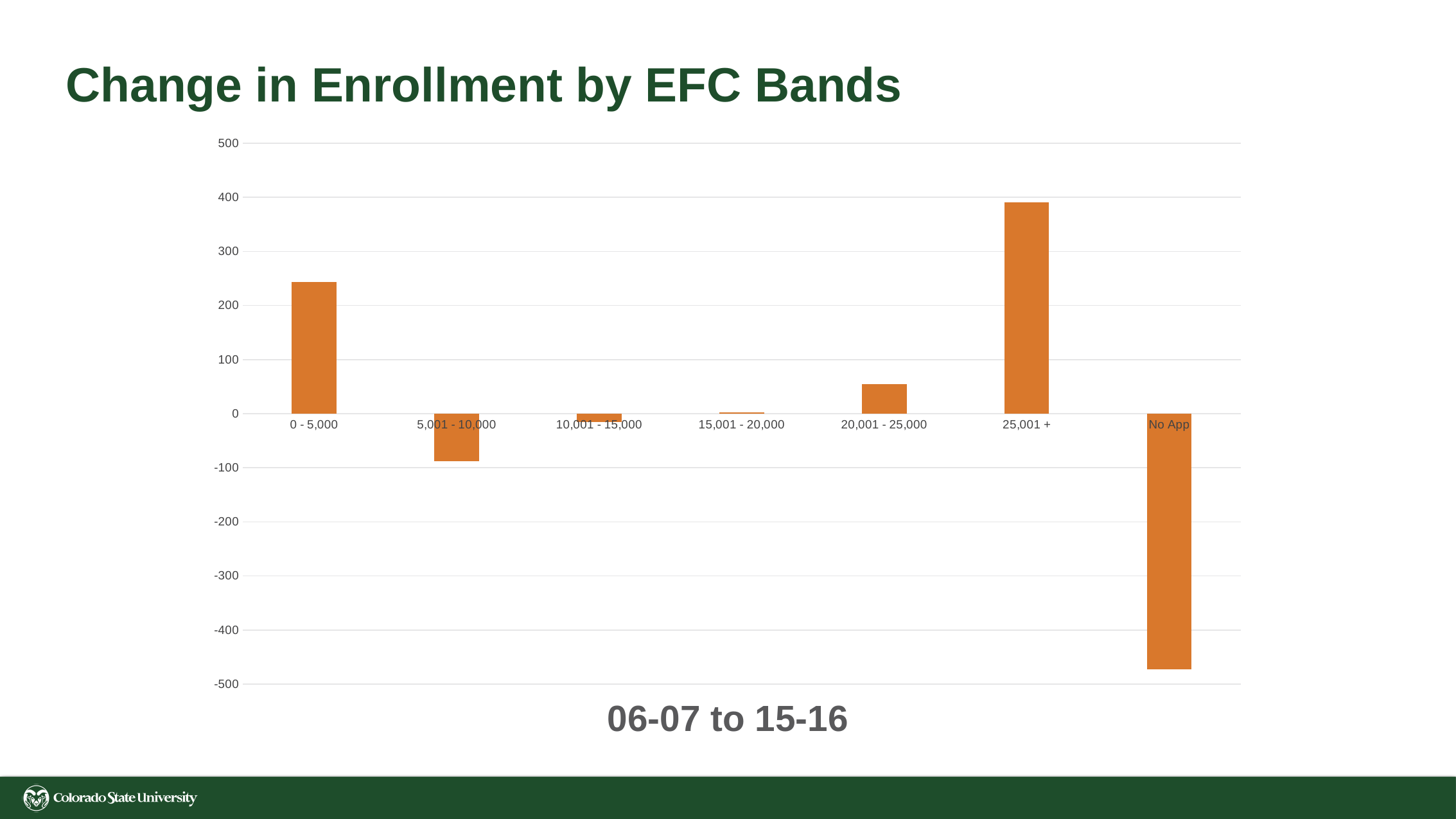
Which category has the lowest change in enrollment? No App What is the title of the chart? Change in Enrollment by EFC Bands Is the value for 20,001 - 25,000 greater or less than 100? less Which is larger, the value for 25,001 + or the value for 0 - 5,000? 25,001 + How many EFC band categories are plotted on the chart? 7 Is the value for 0 - 5,000 greater or less than 200? greater Is the value for 25,001 + greater or less than 300? greater What kind of chart is shown on the slide? bar chart Which category has the highest change in enrollment? 25,001 + Which is larger, the value for 0 - 5,000 or the value for 20,001 - 25,000? 0 - 5,000